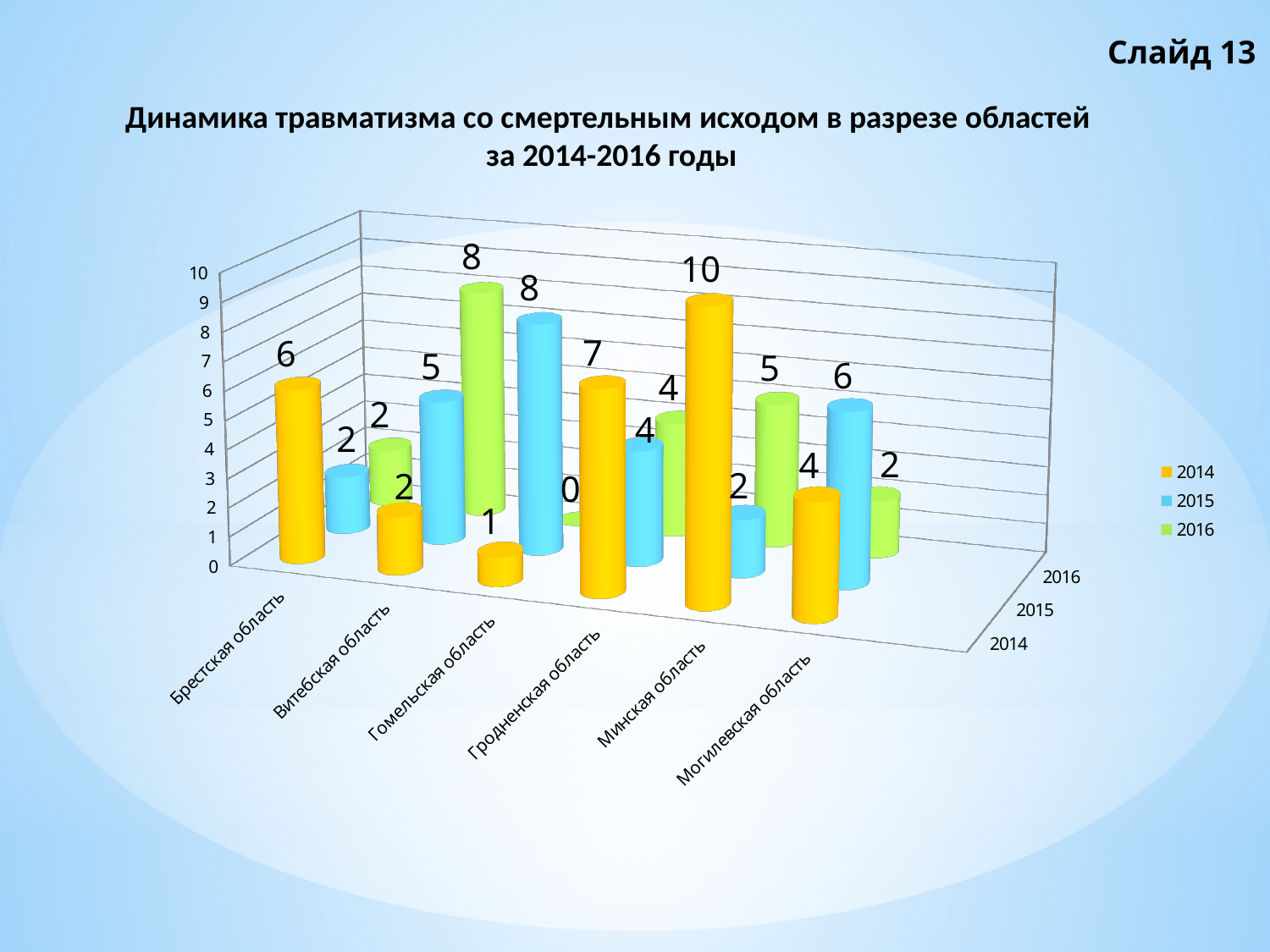
What kind of chart is shown on the slide? Bar chart What is the value for Гомельская область in the 2015 series? 8 How many regions are shown on the x axis? 6 What is the value for Минская область in the 2014 series? 10 What is the difference between the 2014 value for Минская область and the 2014 value for Брестская область? 4 Which colour represents the 2016 series in the legend? Green Which region has the highest value in the 2014 series? Минская область What is the value for Гомельская область in the 2016 series? 0 Which region has the lowest value in the 2014 series? Гомельская область Which is larger: the 2015 value for Могилевская область or the 2015 value for Гродненская область? Могилевская область How many series does the legend list? 3 What is the value for Витебская область in the 2016 series? 8